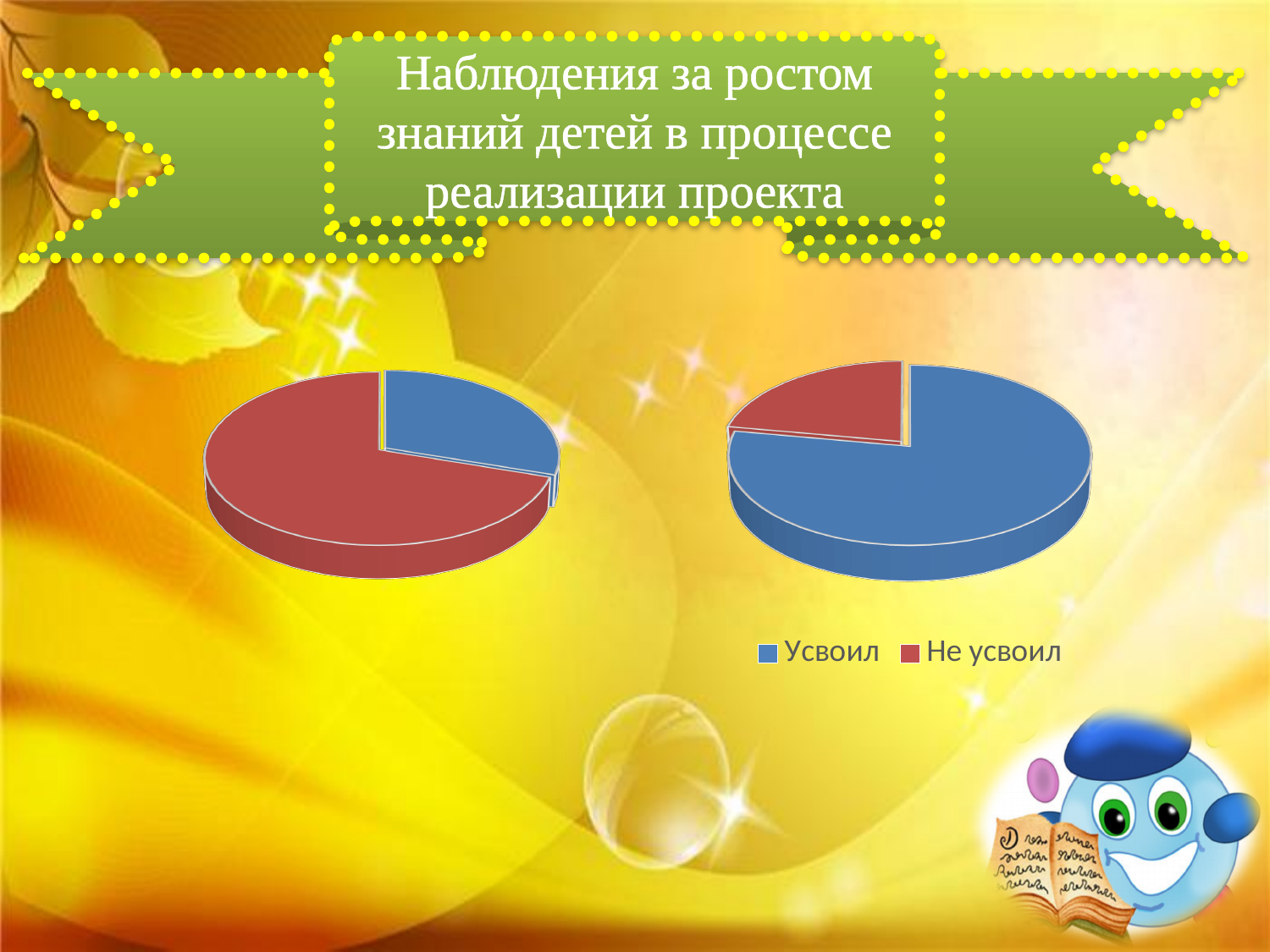
How many slices does each pie chart have? 2 In the right pie chart, which slice is larger, Усвоил or Не усвоил? Усвоил How many pie charts are on the slide? 2 What kind of charts are shown on the slide? Pie charts Which colour represents Не усвоил in the legend? Red Which colour represents Усвоил in the legend? Blue How many entries does the legend list? 2 In the right pie chart, which category has the largest slice? Усвоил In the left pie chart, which slice is larger, Усвоил or Не усвоил? Не усвоил In the left pie chart, which category has the smallest slice? Усвоил